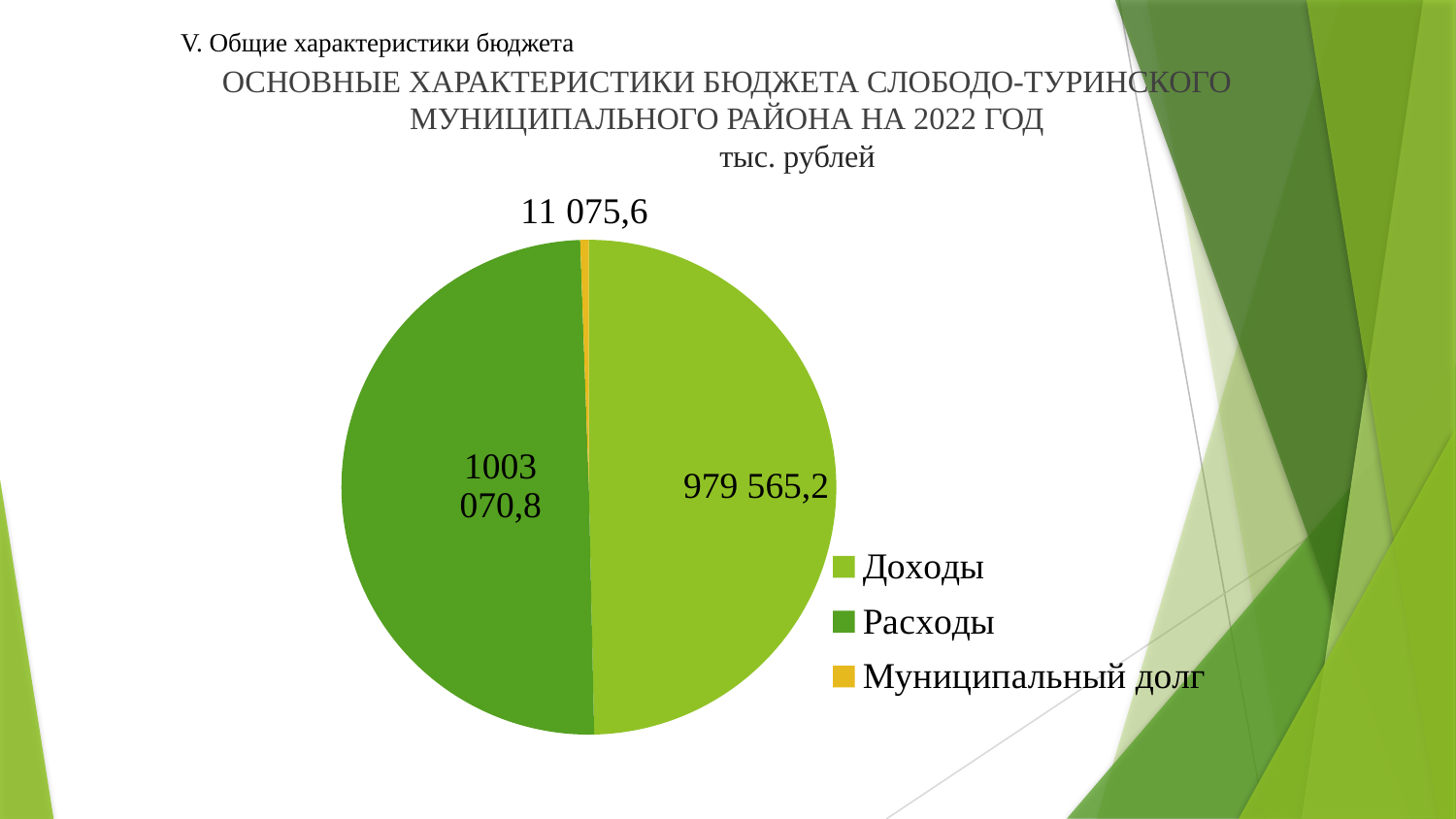
Which category has the smallest slice in the pie chart? Муниципальный долг What unit is stated under the chart title? тыс. рублей How many entries does the legend list? 3 What type of chart is shown on the slide? pie chart Which category has the largest slice in the pie chart? Расходы How many categories does the pie chart have? 3 What is the value for Доходы in the pie chart? 979 565,2 Which is larger, Расходы or Доходы? Расходы What is the difference between Доходы and Муниципальный долг? 968 489,6 What is the value for Расходы in the pie chart? 1003 070,8 What is the value for Муниципальный долг in the pie chart? 11 075,6 What is the difference between Расходы and Доходы? 23 505,6